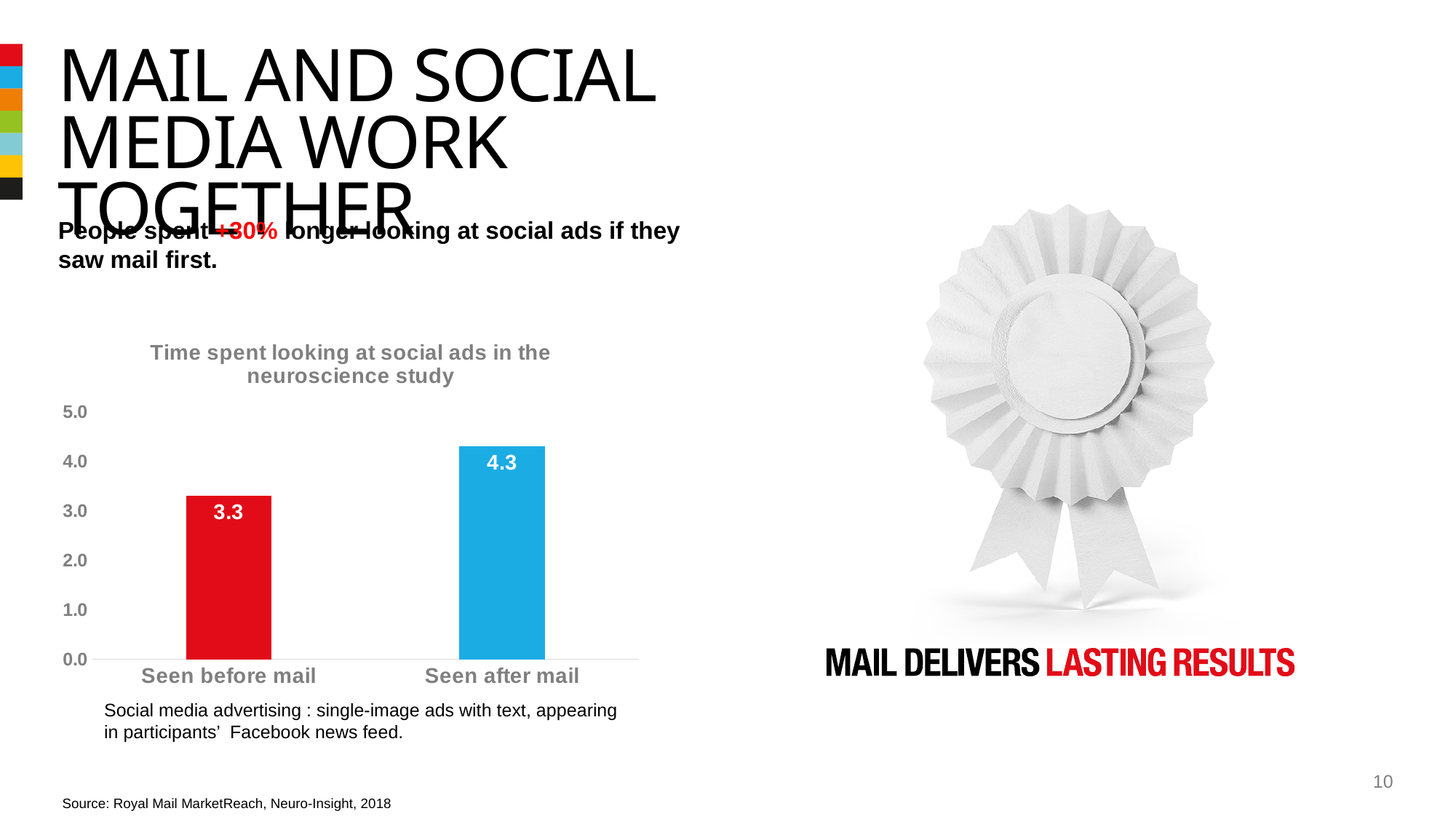
Which category has the lowest value? Seen before mail Which is larger, the value for "Seen before mail" or "Seen after mail"? Seen after mail Which category has the highest value? Seen after mail What is the value for "Seen after mail"? 4.3 How many categories are shown in the chart? 2 What kind of chart is shown on the slide? Bar chart What is the difference between the values for "Seen after mail" and "Seen before mail"? 1.0 Is the value for "Seen before mail" greater or less than 4.0? less What colour is the bar for "Seen after mail"? Blue What is the title of the chart? Time spent looking at social ads in the neuroscience study What is the value for "Seen before mail"? 3.3 Is the value for "Seen after mail" greater or less than 4.0? greater